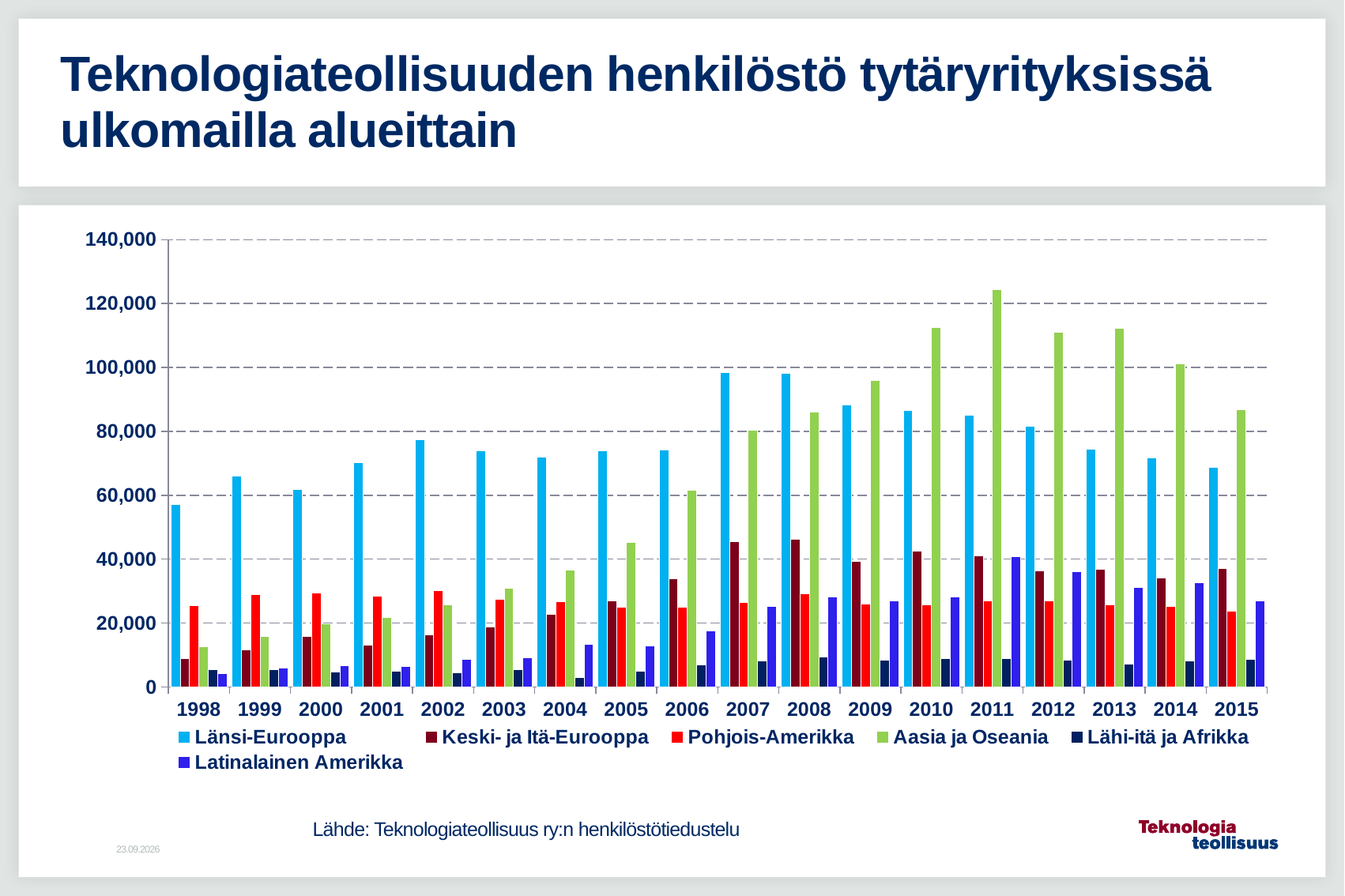
In which year is the value for Aasia ja Oseania lowest? 1998 What kind of chart is shown on the slide? bar chart Is the value for Länsi-Eurooppa in 2007 greater or less than 80,000? greater How many years are shown on the x axis? 18 In 2015, which is larger: Aasia ja Oseania or Länsi-Eurooppa? Aasia ja Oseania Does the value for Aasia ja Oseania rise or fall from 1998 to 2011? rise Which series has the highest value in 2008? Länsi-Eurooppa How many series does the legend list? 6 Is the value for Länsi-Eurooppa in 1998 greater or less than 60,000? less Is the value for Aasia ja Oseania in 2011 greater or less than 120,000? greater In which year is the value for Aasia ja Oseania highest? 2011